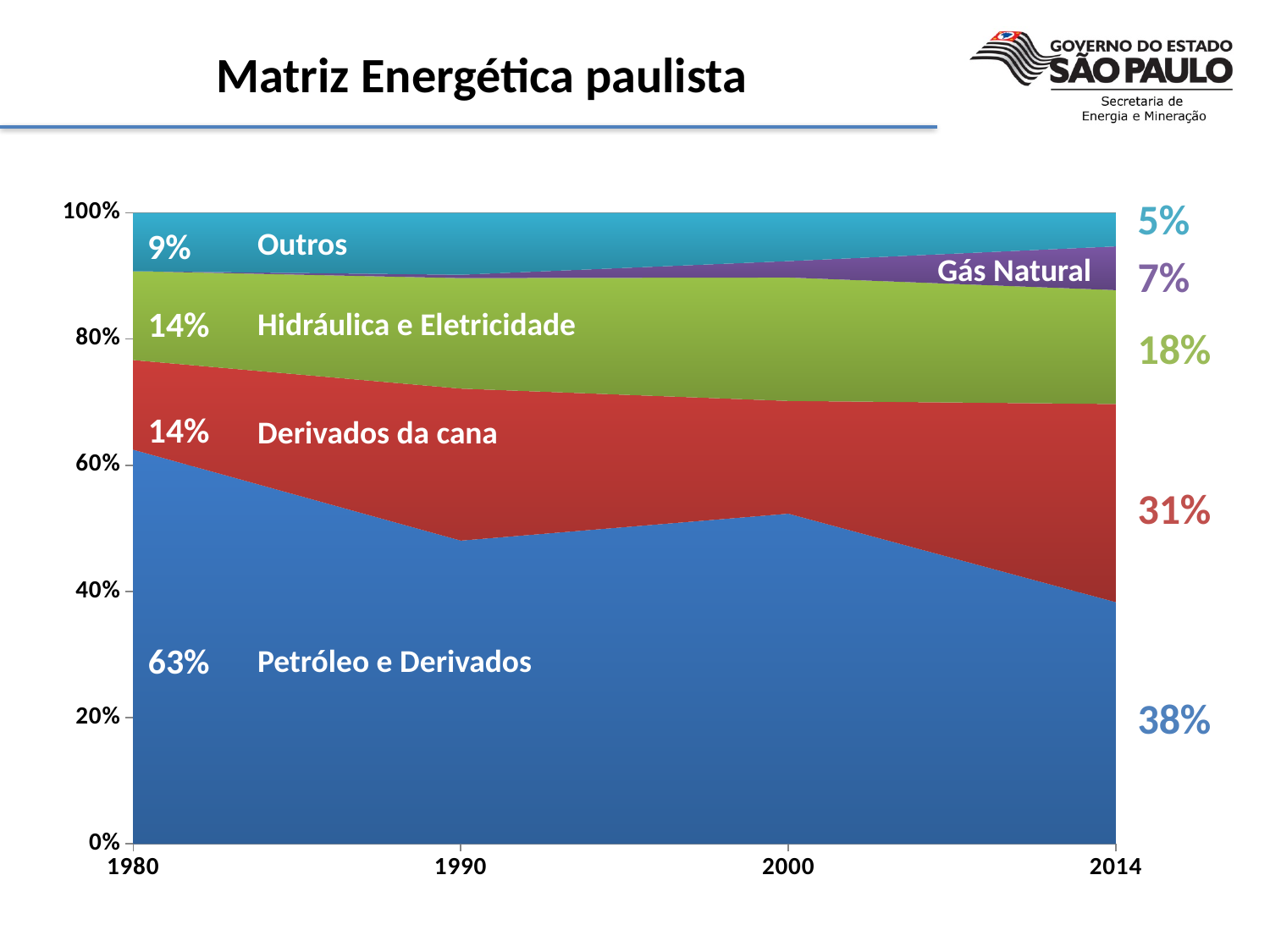
By how many percentage points did the share of Petróleo e Derivados fall between 1980 and 2014? 25 percentage points Which energy source had the largest share in 2014? Petróleo e Derivados What share of the energy matrix did Petróleo e Derivados have in 2014? 38% Does the share of Petróleo e Derivados rise or fall from 1980 to 2014? Fall What share did Hidráulica e Eletricidade have in 1980? 14% What share did Gás Natural have in 2014? 7% What share of the energy matrix did Petróleo e Derivados have in 1980? 63% How many years are marked on the x axis of the chart? 4 What share did Derivados da cana have in 2014? 31% By how many percentage points did the share of Derivados da cana grow between 1980 and 2014? 17 percentage points Which energy source had the smallest share in 2014? Outros What kind of chart is shown on the slide? Stacked area chart